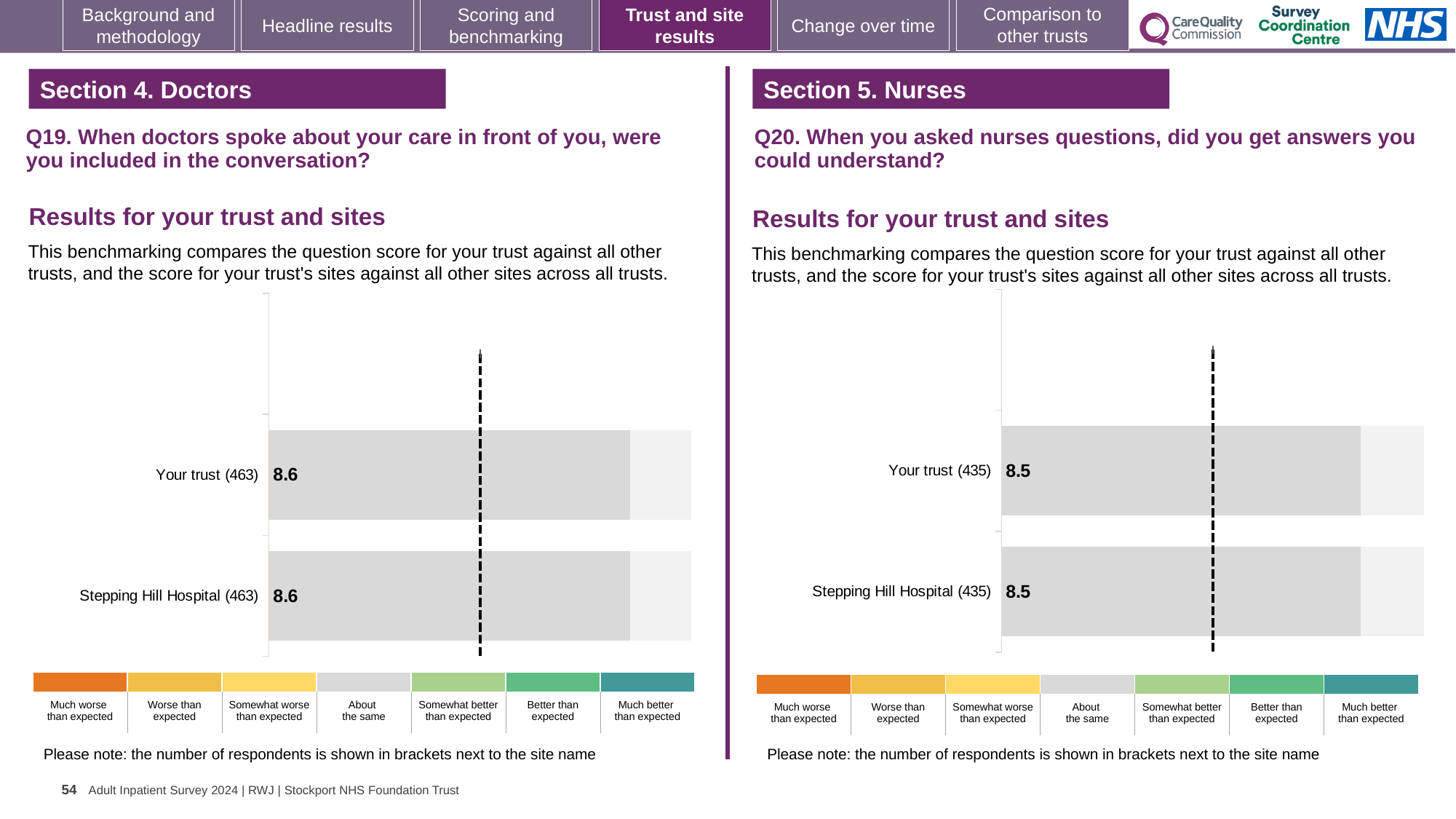
On the Q20 chart (right), how many respondents are shown in brackets for Stepping Hill Hospital? 435 Is the Your trust score on the Q19 chart (left) larger than the Your trust score on the Q20 chart (right)? Yes, 8.6 is larger than 8.5 How many bars are plotted on the Q20 chart (right)? 2 On the Q20 chart (right), what is the score for Your trust? 8.5 On the Q19 chart (left), what is the score for Your trust? 8.6 On the Q19 chart (left), how many respondents are shown in brackets for Your trust? 463 On the Q19 chart (left), what is the score for Stepping Hill Hospital? 8.6 On the Q20 chart (right), what is the difference between the Your trust score and the Stepping Hill Hospital score? 0 How many bars are plotted on the Q19 chart (left)? 2 On the Q20 chart (right), what is the score for Stepping Hill Hospital? 8.5 On the Q19 chart (left), what is the difference between the Your trust score and the Stepping Hill Hospital score? 0 What kind of chart is used for the Q19 results on the left? Bar chart